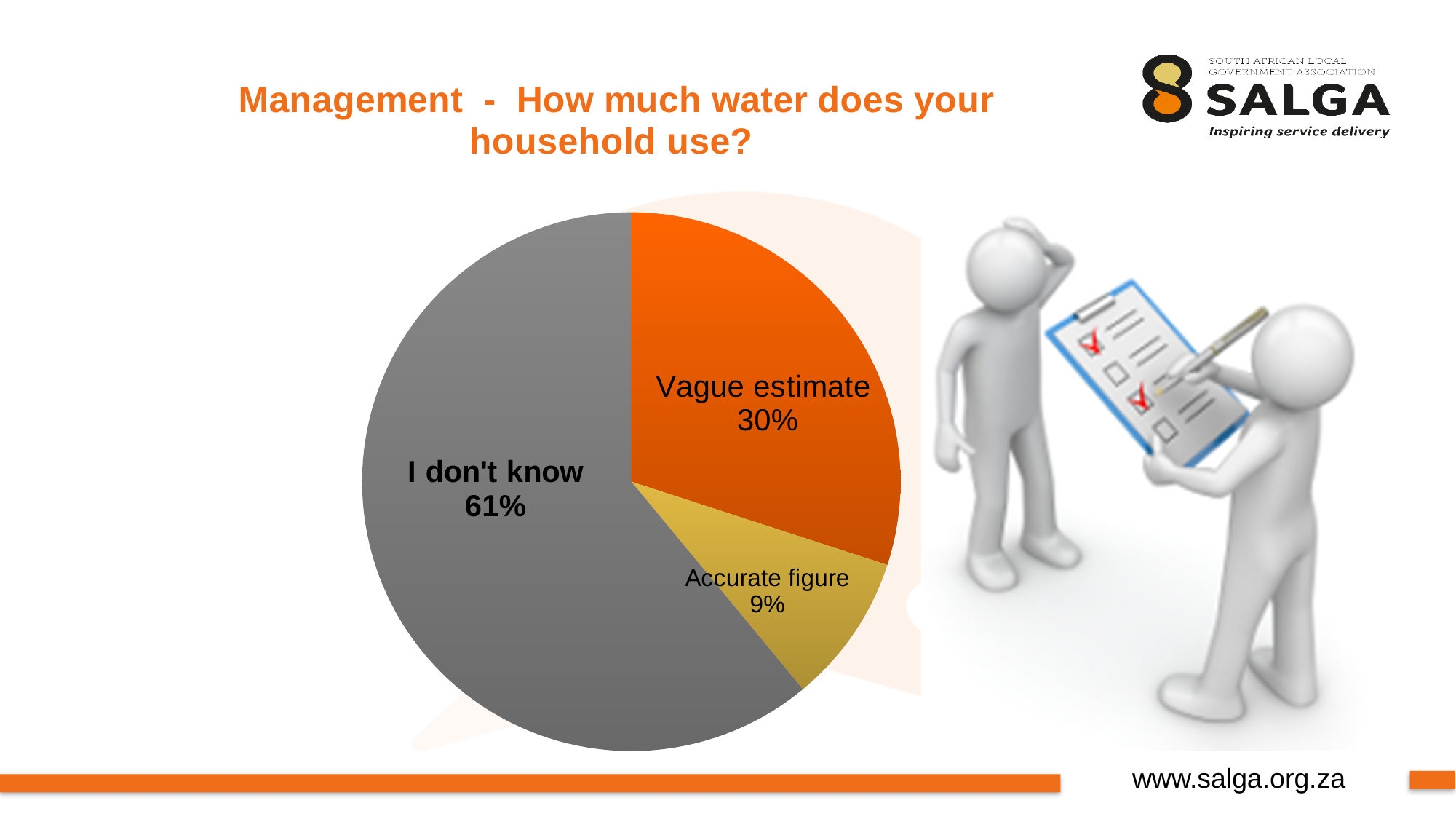
What is the difference in percentage points between "I don't know" and "Vague estimate"? 31 Which is larger: the share for "Vague estimate" or the share for "Accurate figure"? Vague estimate How many slices does the pie chart have? 3 What is the difference in percentage points between "Vague estimate" and "Accurate figure"? 21 Which response has the largest share of the pie? I don't know What is the title of the slide containing the pie chart? Management - How much water does your household use? What share of respondents answered "I don't know"? 61% What colour is the "I don't know" slice of the pie chart? grey What share of respondents gave an "Accurate figure"? 9% Which response has the smallest share of the pie? Accurate figure What kind of chart is shown on the slide? pie chart What share of respondents gave a "Vague estimate"? 30%